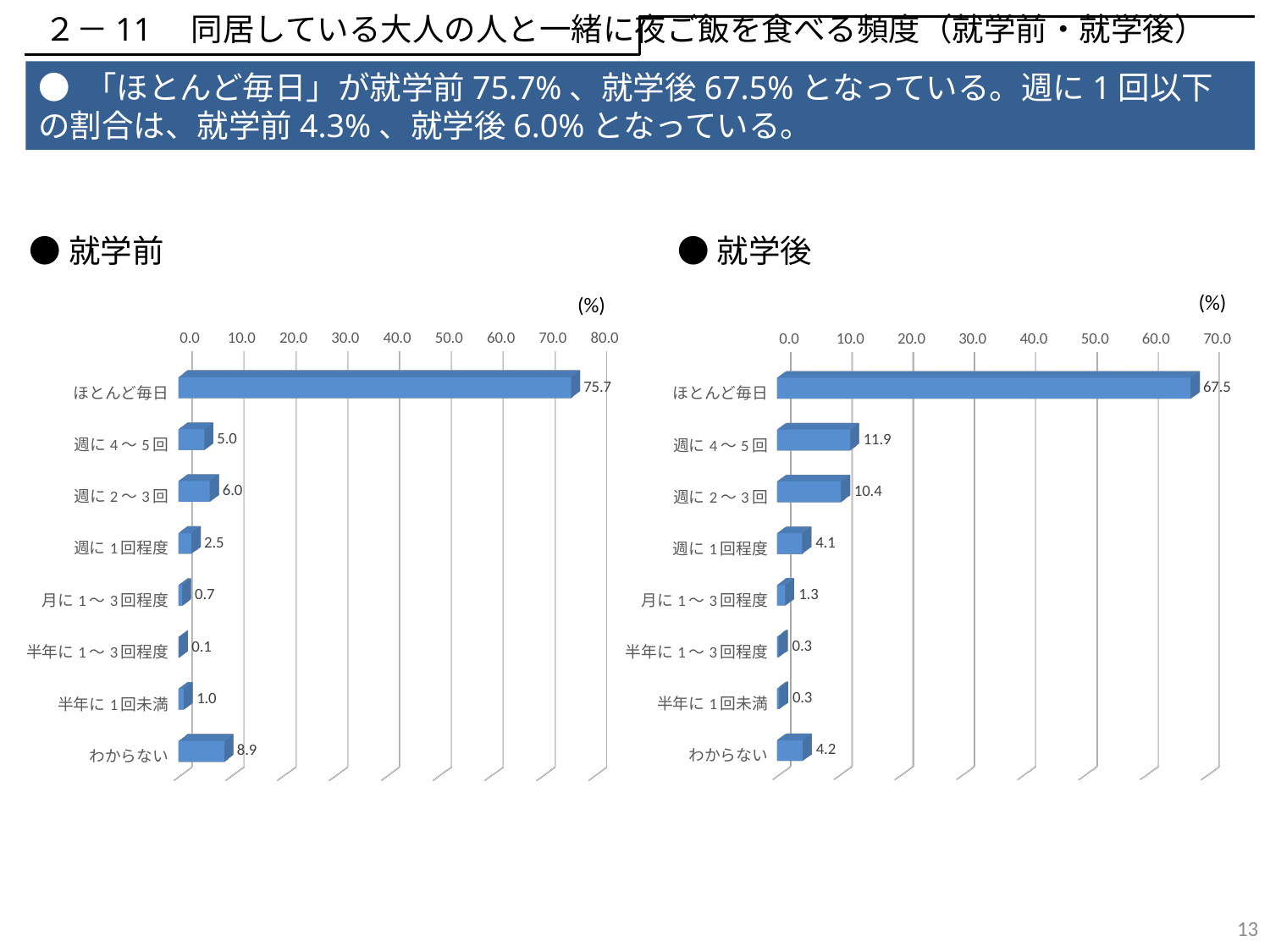
In the 就学後 chart, what is the value for 週に1回程度? 4.1 In the 就学後 chart, what is the difference between 週に4〜5回 and 週に2〜3回? 1.5 In the 就学後 chart, what is the value for 週に4〜5回? 11.9 How many categories are shown in the 就学後 chart? 8 In the 就学後 chart, which category has the highest value? ほとんど毎日 In the 就学前 chart, which category has the lowest value? 半年に1〜3回程度 In the 就学前 chart, what is the value for ほとんど毎日? 75.7 What type of chart is the 就学前 chart? Bar chart In the 就学前 chart, what is the value for わからない? 8.9 In the 就学前 chart, which is larger: 週に2〜3回 or 週に4〜5回? 週に2〜3回 What is the maximum value shown on the x axis of the 就学前 chart? 80.0 What is the difference between the ほとんど毎日 value in the 就学前 chart and the ほとんど毎日 value in the 就学後 chart? 8.2